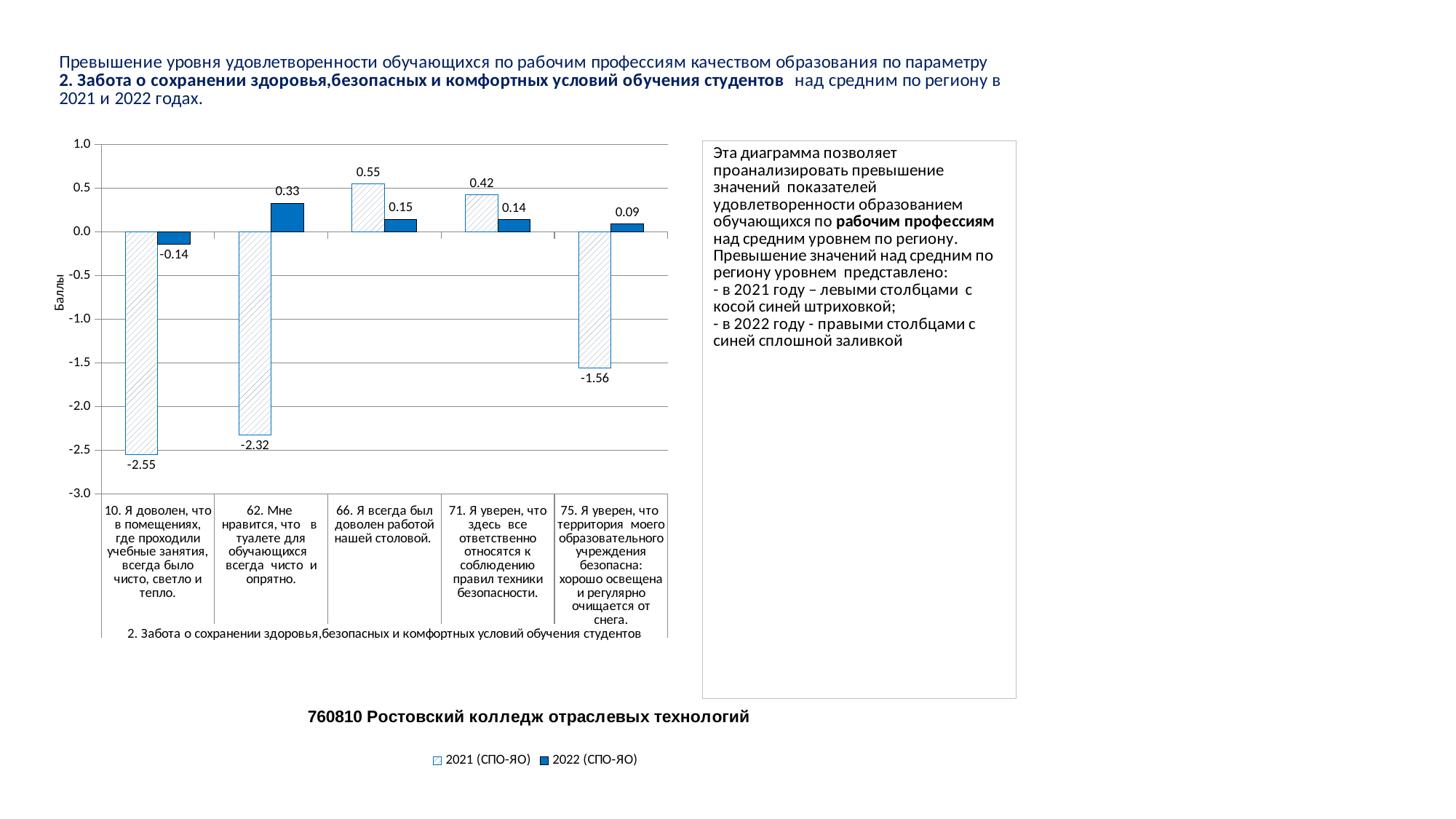
What is the 2022 (СПО-ЯО) value for category 66 (Я всегда был доволен работой нашей столовой)? 0.15 What is the difference between the 2021 and 2022 values for category 71 (Я уверен, что здесь все ответственно относятся к соблюдению правил техники безопасности)? 0.28 What is the 2021 (СПО-ЯО) value for category 75 (Я уверен, что территория моего образовательного учреждения безопасна)? -1.56 What is the 2021 (СПО-ЯО) value for category 10 (Я доволен, что в помещениях, где проходили учебные занятия, всегда было чисто, светло и тепло)? -2.55 Which category has the lowest 2021 (СПО-ЯО) value? 10. Я доволен, что в помещениях, где проходили учебные занятия, всегда было чисто, светло и тепло. How many categories are shown on the x axis of the chart? 5 For category 62, which series has the larger value: 2021 (СПО-ЯО) or 2022 (СПО-ЯО)? 2022 (СПО-ЯО) Which category has the highest 2021 (СПО-ЯО) value? 66. Я всегда был доволен работой нашей столовой. Which category has the lowest 2022 (СПО-ЯО) value? 10. Я доволен, что в помещениях, где проходили учебные занятия, всегда было чисто, светло и тепло. What is the 2022 (СПО-ЯО) value for category 62 (Мне нравится, что в туалете для обучающихся всегда чисто и опрятно)? 0.33 What type of chart is shown on the slide? Bar chart How many series does the chart legend list? 2